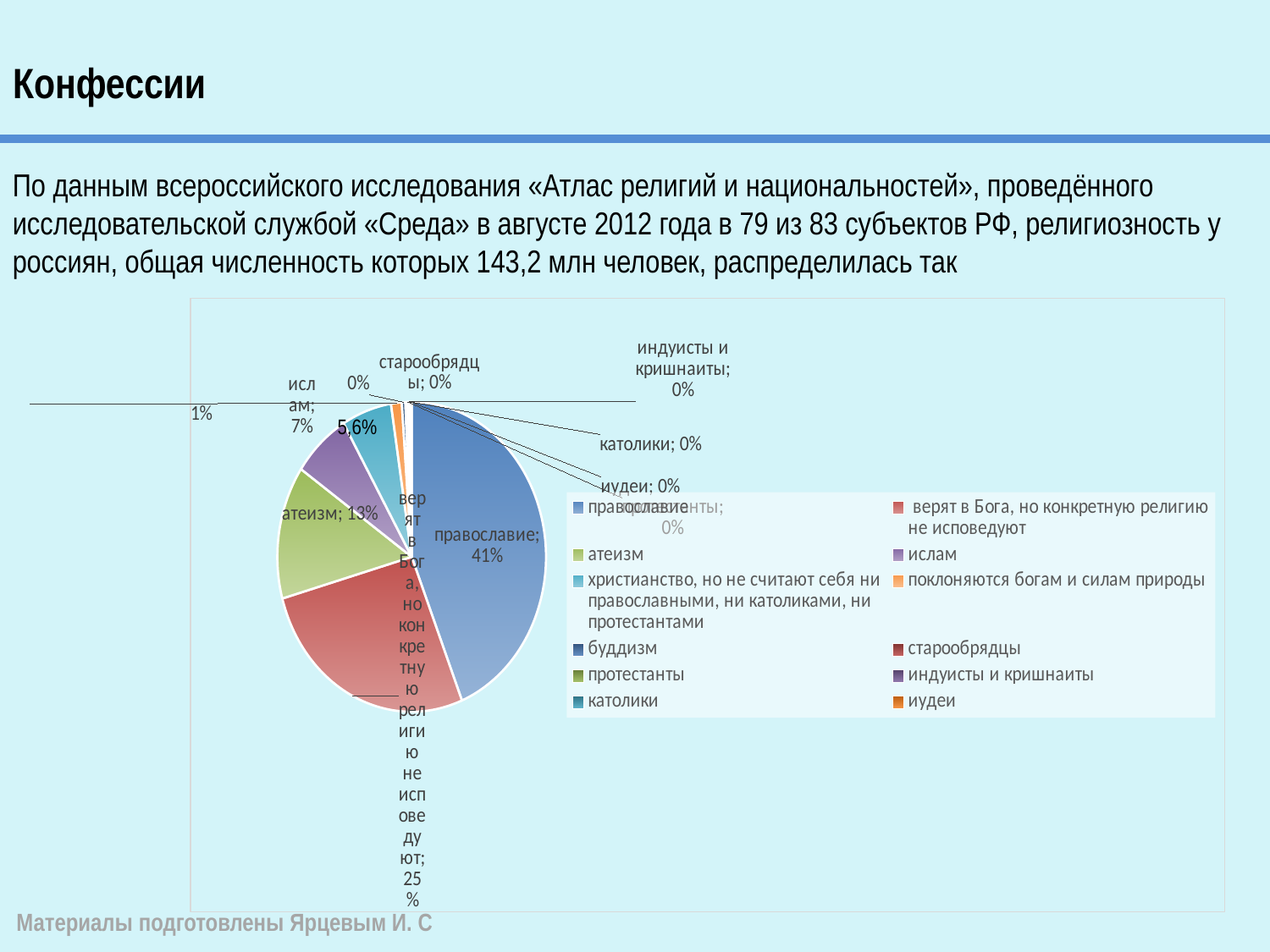
What percentage is shown for ислам? 7% How many entries does the chart legend list? 12 By how many percentage points does православие exceed 'верят в Бога, но конкретную религию не исповедуют'? 16% By how many percentage points does православие exceed атеизм? 28% What share of the pie is labelled for православие? 41% What percentage is shown for старообрядцы? 0% Which is larger, the slice for атеизм or the slice for ислам? атеизм Which category has the largest slice of the pie? православие What percentage is shown for the slice 'верят в Бога, но конкретную религию не исповедуют'? 25% What kind of chart is shown on the slide? pie chart What percentage is shown for католики? 0% What percentage is shown for атеизм? 13%